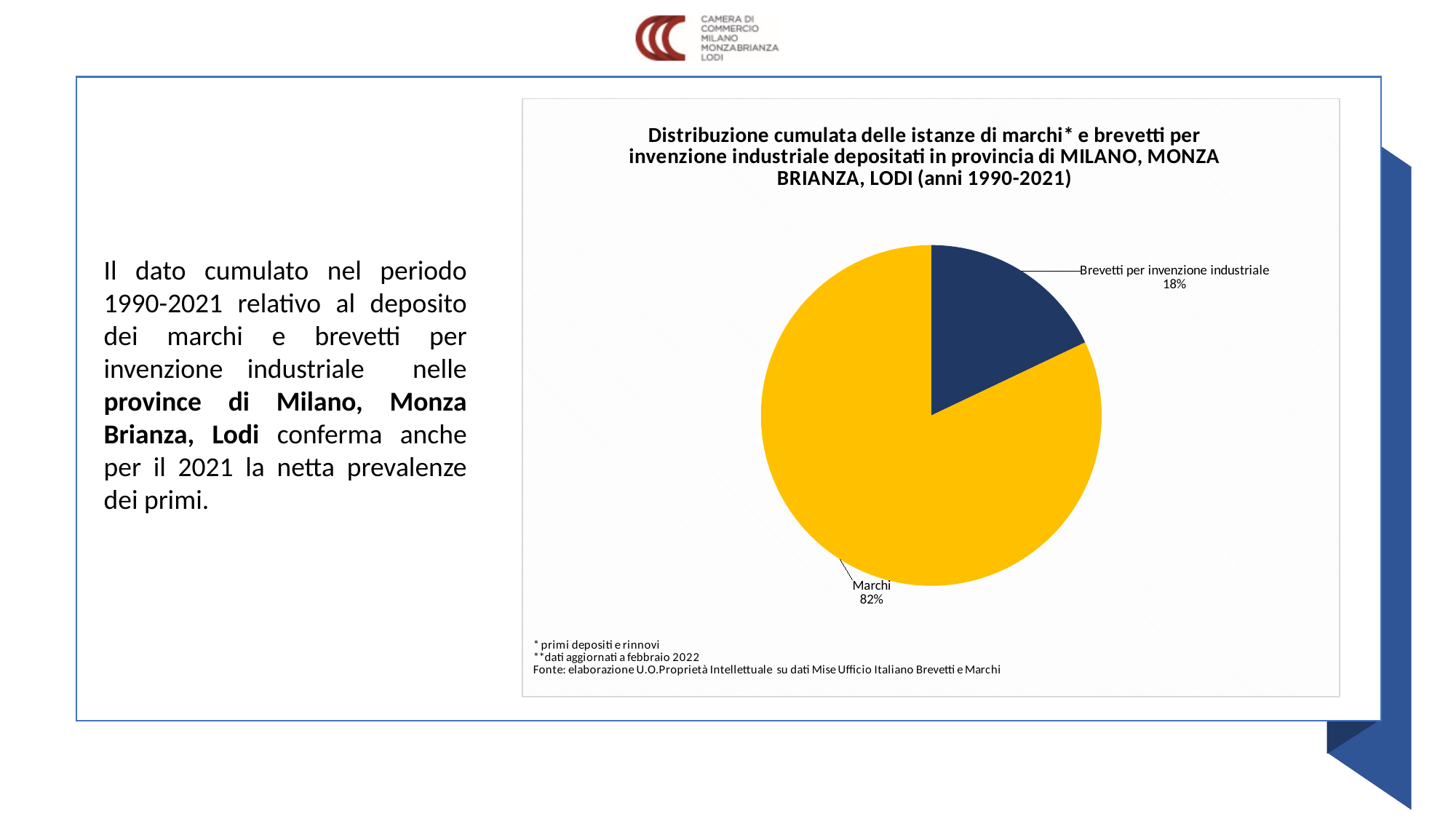
What colour is the Marchi slice? Yellow What period of years does the chart title say the data covers? 1990-2021 How many slices does the pie chart have? 2 Which slice of the pie is the smallest? Brevetti per invenzione industriale What share of the pie does Brevetti per invenzione industriale represent? 18% What share of the pie does Marchi represent? 82% What is the difference in percentage points between the Marchi slice and the Brevetti per invenzione industriale slice? 64 What kind of chart is shown on the slide? Pie chart Which slice of the pie is the largest? Marchi Which is larger, the Marchi slice or the Brevetti per invenzione industriale slice? Marchi